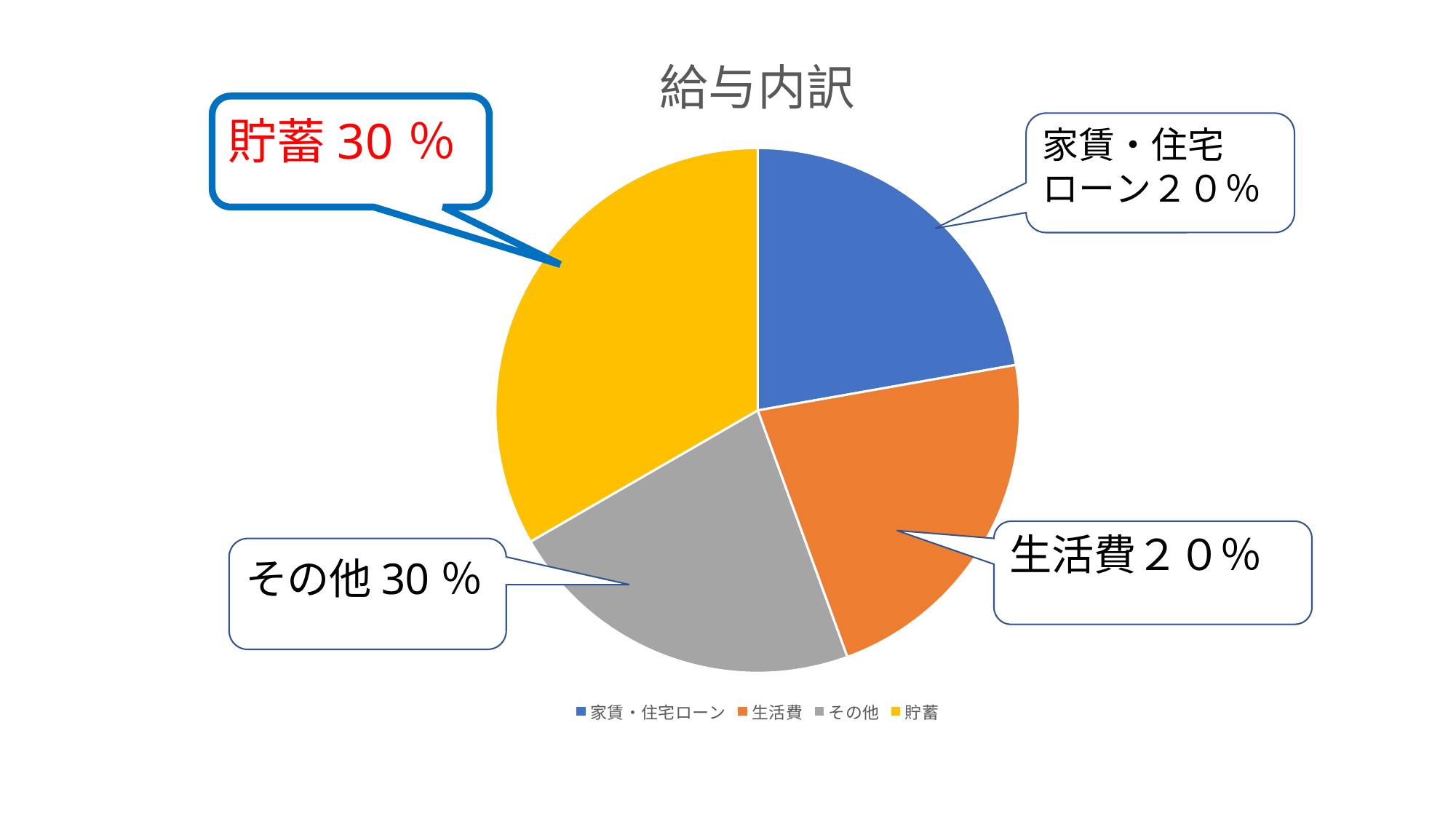
What is the difference in percentage points between 貯蓄 and 家賃・住宅ローン? 10 What is the value shown for 生活費? ２０％ What share of the pie is 貯蓄? 30 % How many slices does the pie chart have? 4 What is the value shown for 家賃・住宅ローン? ２０％ What is the title of the chart? 給与内訳 What colour is the 貯蓄 slice? yellow What kind of chart is shown on the slide? pie chart Which is larger, 貯蓄 or 生活費? 貯蓄 How many entries does the legend list? 4